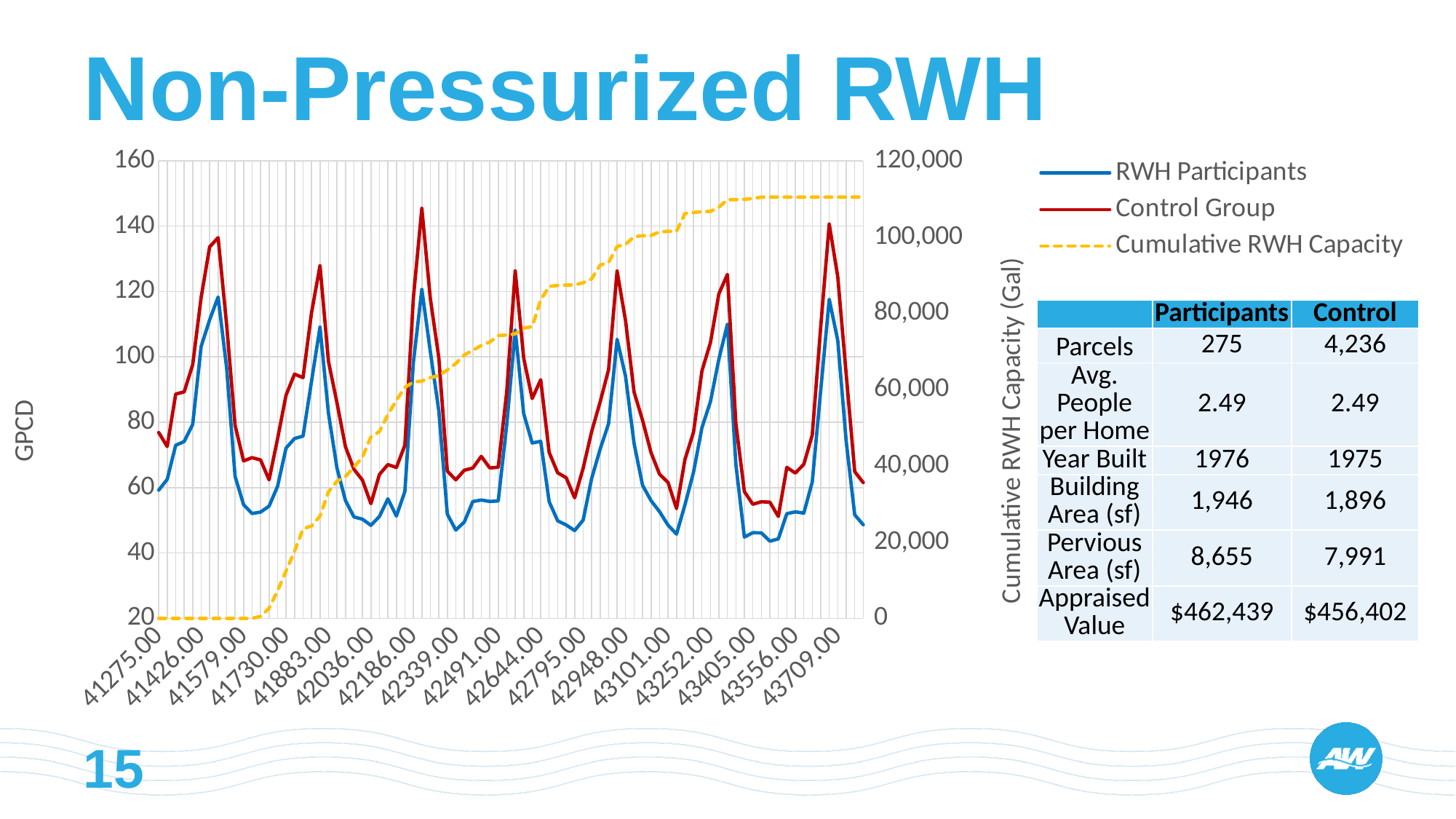
What is the title of the left vertical axis? GPCD Which series is drawn as a dashed line? Cumulative RWH Capacity Does the Cumulative RWH Capacity series rise or fall along the x axis? rise How many series does the chart legend list? 3 Which series reaches the highest GPCD value on the chart, RWH Participants or Control Group? Control Group How many tick labels are shown on the x axis? 17 Is the highest peak of the Control Group series greater or less than 140 GPCD? greater Is the Control Group value at 41275.00 greater or less than 60 GPCD? greater At the peak near 42339.00, which series has the larger GPCD value, RWH Participants or Control Group? Control Group Is the Cumulative RWH Capacity value at 41275.00 greater or less than 20,000? less What kind of chart is shown on the slide? line chart